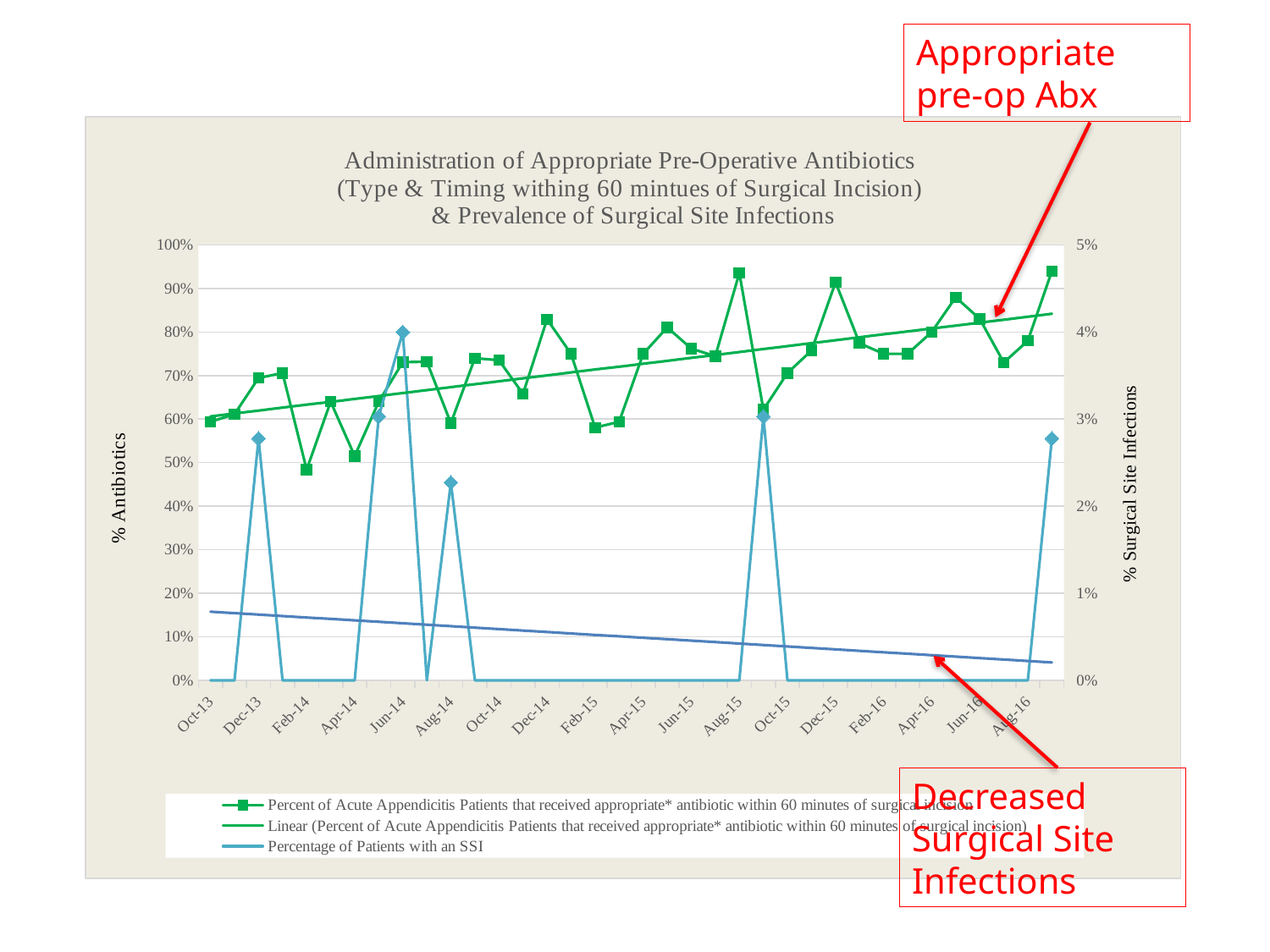
Is the percent of patients receiving appropriate antibiotics in Oct-13 greater or less than 70%? less What is the label on the right-hand vertical axis? % Surgical Site Infections Is the percentage of patients with an SSI in Jun-14 greater or less than 3%? greater Does the linear trendline for the percent of patients receiving appropriate antibiotics rise or fall from Oct-13 to Aug-16? Rise What is the label on the left-hand vertical axis? % Antibiotics Is the percentage of patients with an SSI in Aug-14 greater or less than 3%? less What kind of chart is shown on the slide? Line chart How many month labels are shown along the x axis? 18 How many entries does the chart legend list? 3 Does the trendline for the percentage of patients with an SSI rise or fall across the chart? Fall